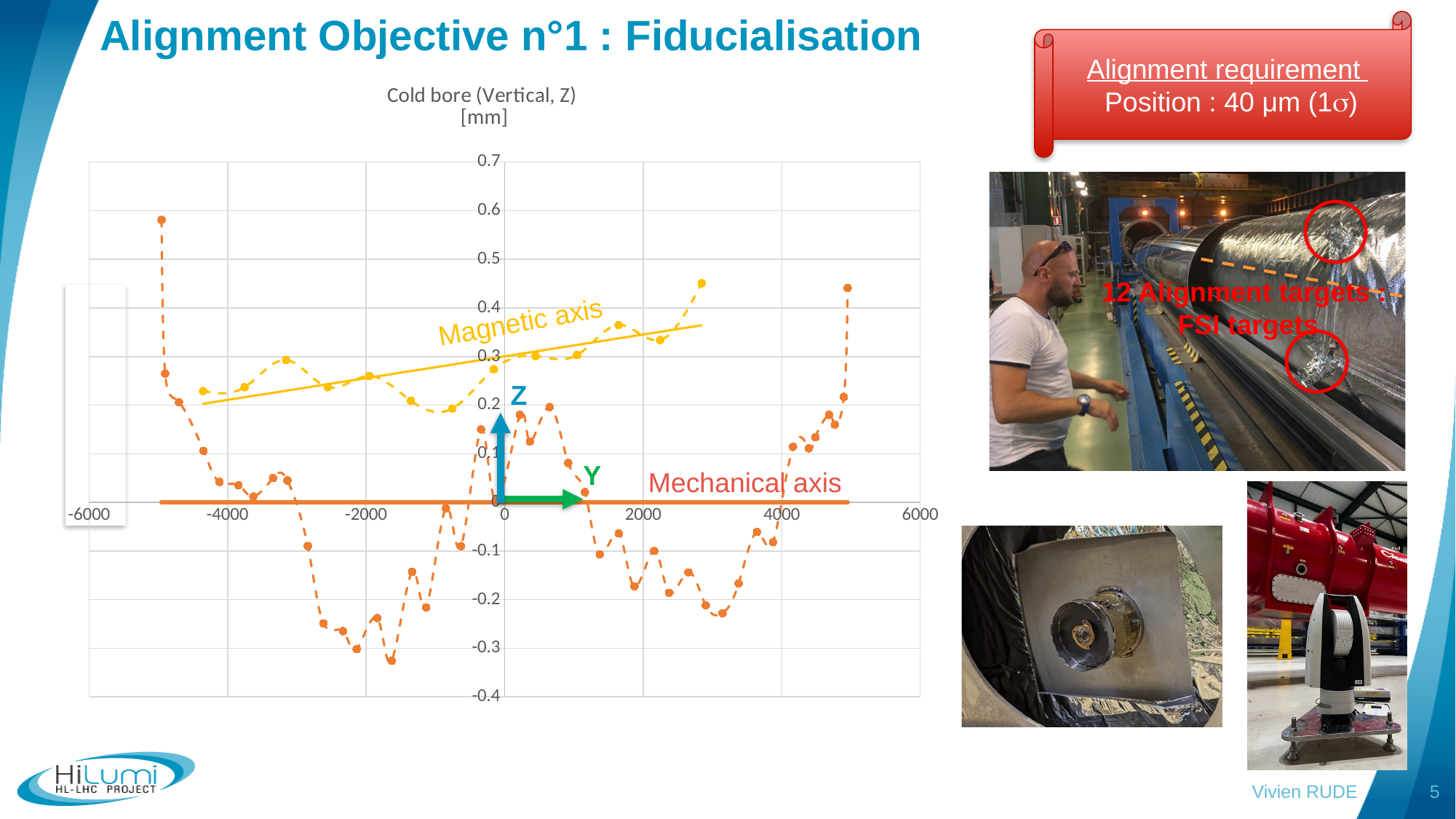
Is the lowest value of the orange series greater or less than -0.3? less What are the two axis labels annotated on the chart? Magnetic axis and Mechanical axis What is the highest tick value shown on the vertical axis? 0.7 Is the value of the orange series at x = 5000 greater or less than 0.4? greater Is the value of the yellow magnetic axis point near x = 2800 greater or less than 0.4? greater Which of the two orange end points is higher: the one at x = -5000 or the one at x = 5000? x = -5000 What is the title of the chart? Cold bore (Vertical, Z) [mm] What kind of chart is shown on the slide? line chart Does the straight magnetic axis trend line rise or fall from left to right? rise